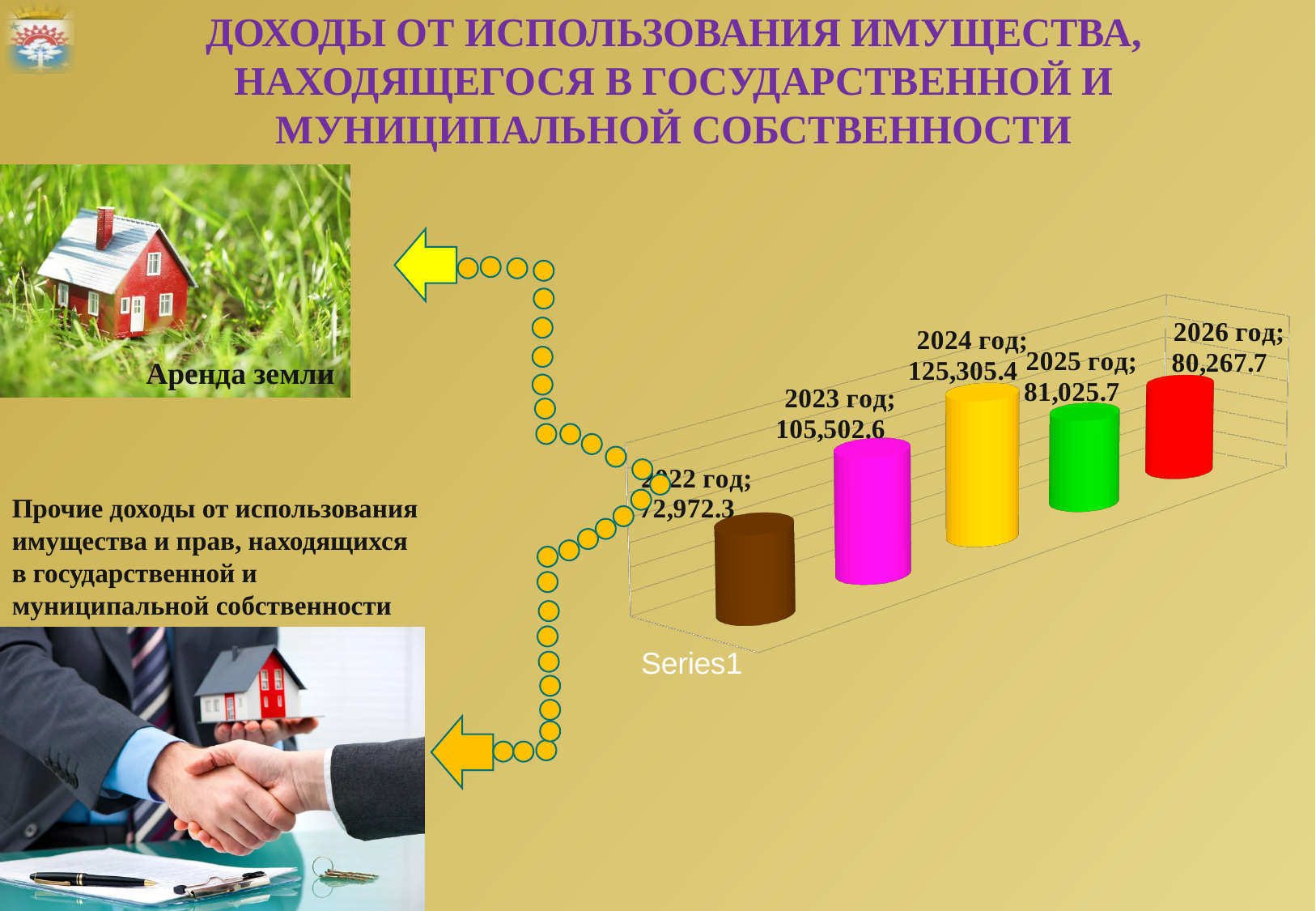
Which year has the highest value in the chart? 2024 год What is the value shown for 2024 год? 125,305.4 Do the values rise or fall from 2022 год to 2024 год? rise What is the difference between the values for 2024 год and 2023 год? 19,802.8 What kind of chart is shown on the slide? bar chart How many years (categories) are plotted in the chart? 5 What is the value shown for 2026 год? 80,267.7 Which year has the lowest value in the chart? 2022 год What is the value shown for 2025 год? 81,025.7 Which is larger, the value for 2023 год or the value for 2025 год? 2023 год What is the difference between the values for 2024 год and 2025 год? 44,279.7 What is the value shown for 2023 год? 105,502.6